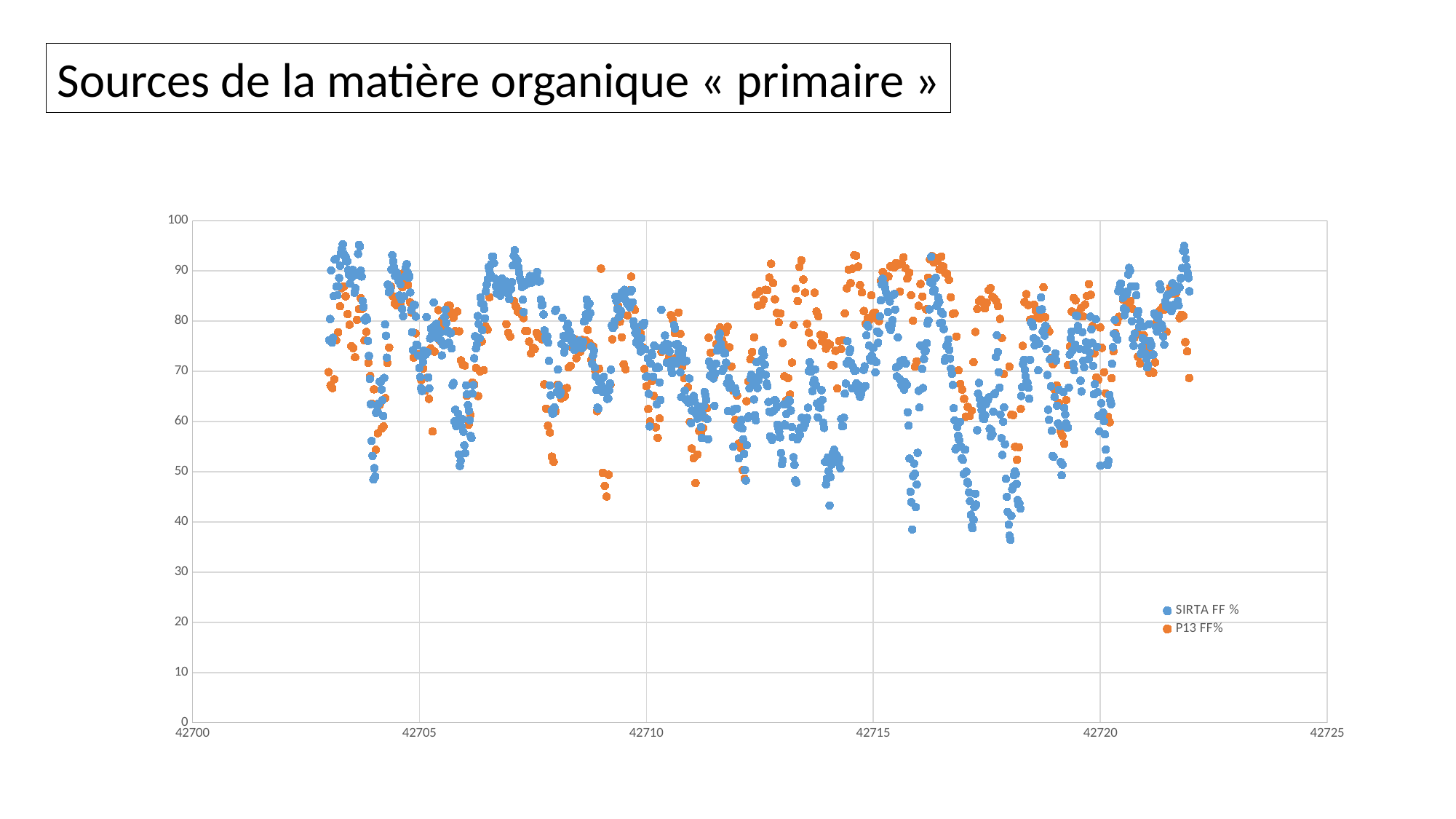
Is the lowest P13 FF% value greater or less than 40? greater Which series reaches the lowest value on the chart, SIRTA FF % or P13 FF%? SIRTA FF % Is the highest SIRTA FF % value greater or less than 90? greater Which colour represents the P13 FF% series? Orange Is the lowest SIRTA FF % value greater or less than 40? less What kind of chart is shown on the slide? Scatter chart What are the two series named in the legend? SIRTA FF % and P13 FF% How many series does the legend list? 2